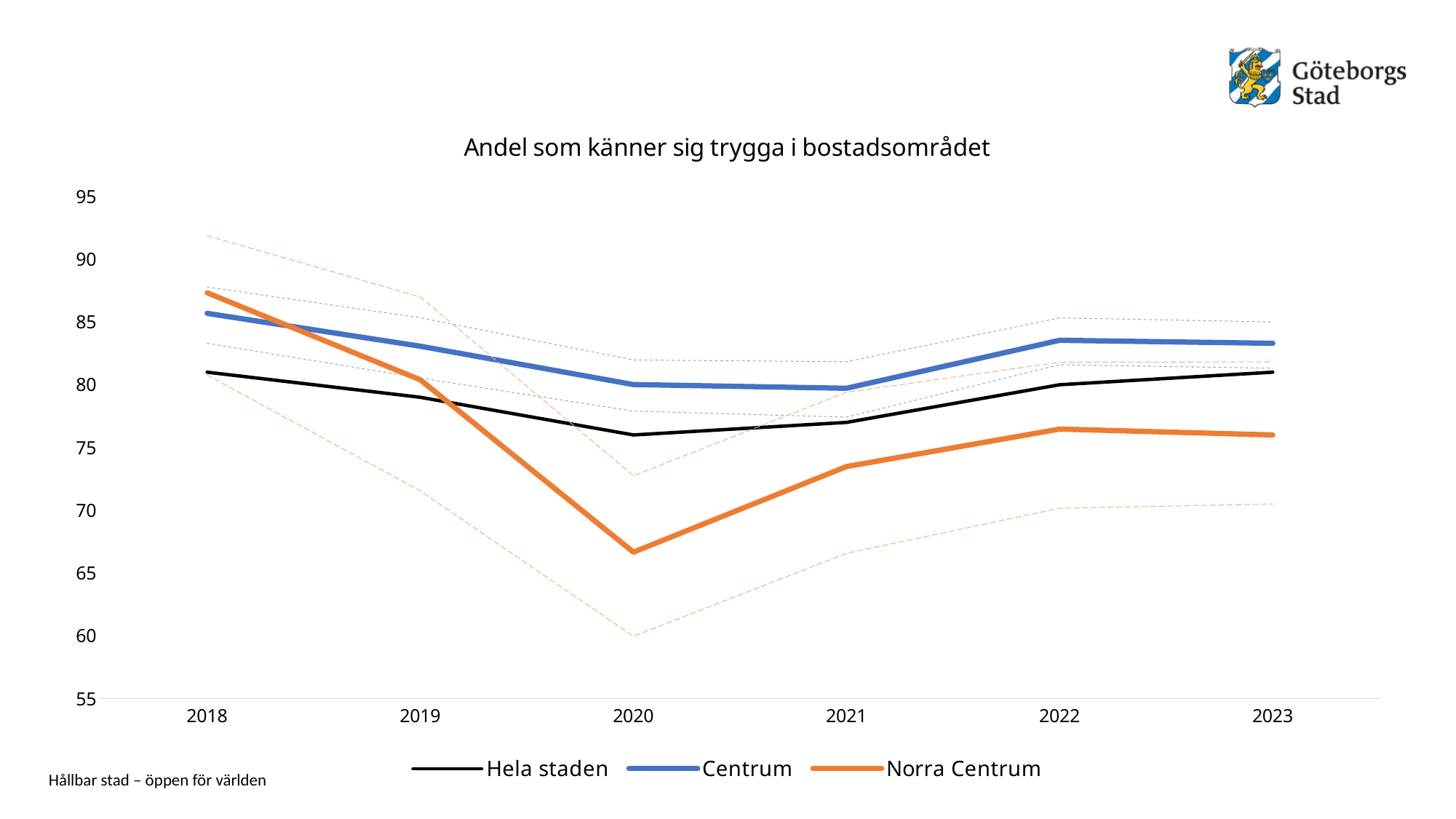
How many years are shown on the x axis? 6 Is the value for Norra Centrum in 2020 greater or less than 70? less In which year is the value for Hela staden lowest? 2020 How many series does the legend list? 3 Does the value for Norra Centrum rise or fall from 2018 to 2020? fall Is the value for Centrum in 2022 greater or less than 80? greater Is the value for Hela staden in 2020 greater or less than 80? less In which year is the value for Norra Centrum lowest? 2020 In which year is the value for Norra Centrum highest? 2018 What is the title of the chart? Andel som känner sig trygga i bostadsområdet In 2020, which is larger: Centrum or Norra Centrum? Centrum What kind of chart is shown on the slide? line chart